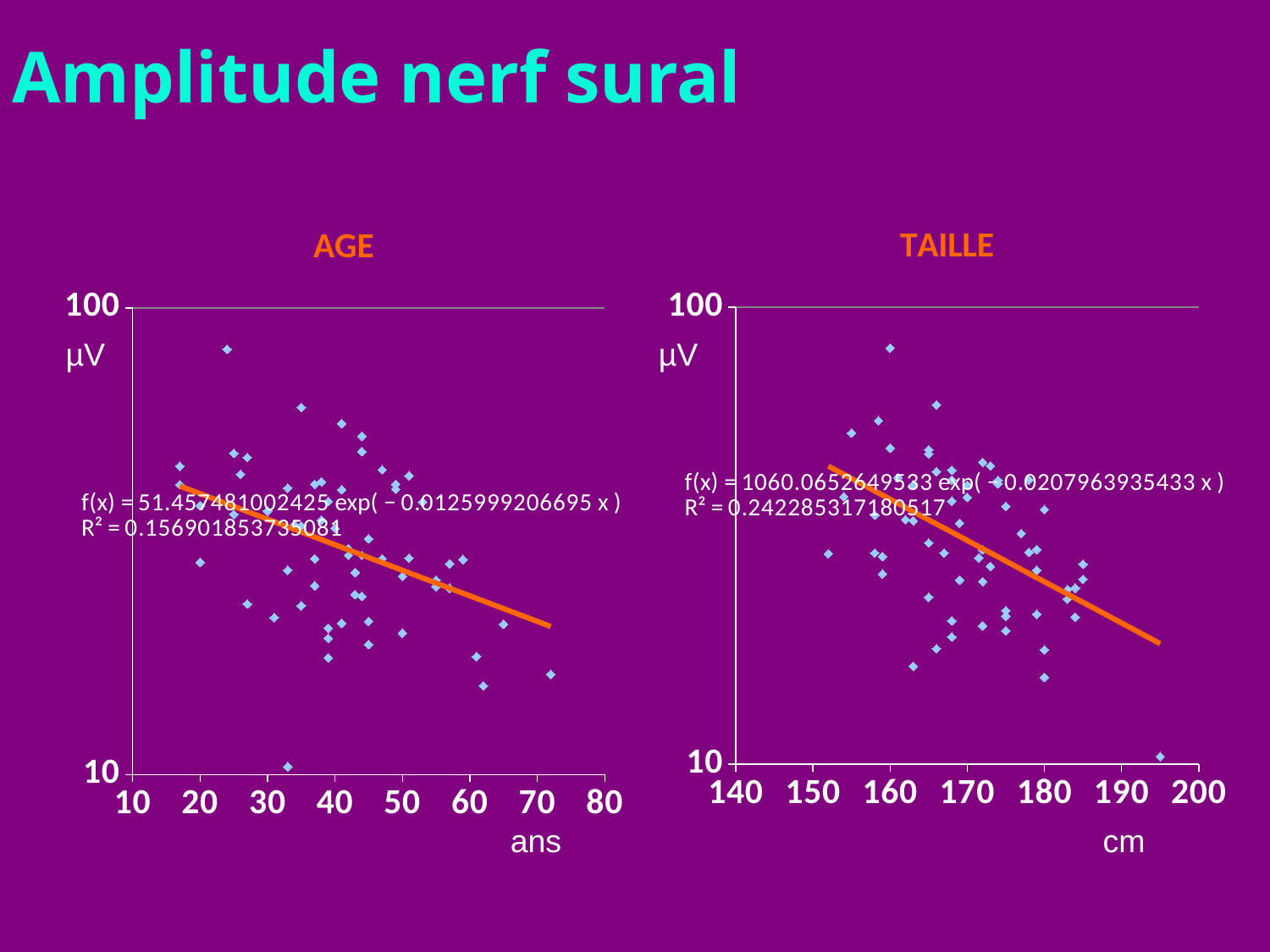
In the AGE chart, does the fitted trend line rise or fall as age increases along the x axis? fall Which chart has the higher R² value, AGE or TAILLE? TAILLE What is the R² value shown on the TAILLE chart? 0.242285317180517 What kind of chart is the TAILLE chart? scatter chart What kind of chart is the AGE chart? scatter chart What is the lowest tick value on the x axis of the TAILLE chart? 140 What is the highest tick value on the y axis of the TAILLE chart? 100 In the TAILLE chart, does the fitted trend line rise or fall as height increases along the x axis? fall What is the unit shown on the x axis of the TAILLE chart? cm What is the highest tick value on the x axis of the AGE chart? 80 What is the unit shown on the x axis of the AGE chart? ans What is the R² value shown on the AGE chart? 0.156901853735081